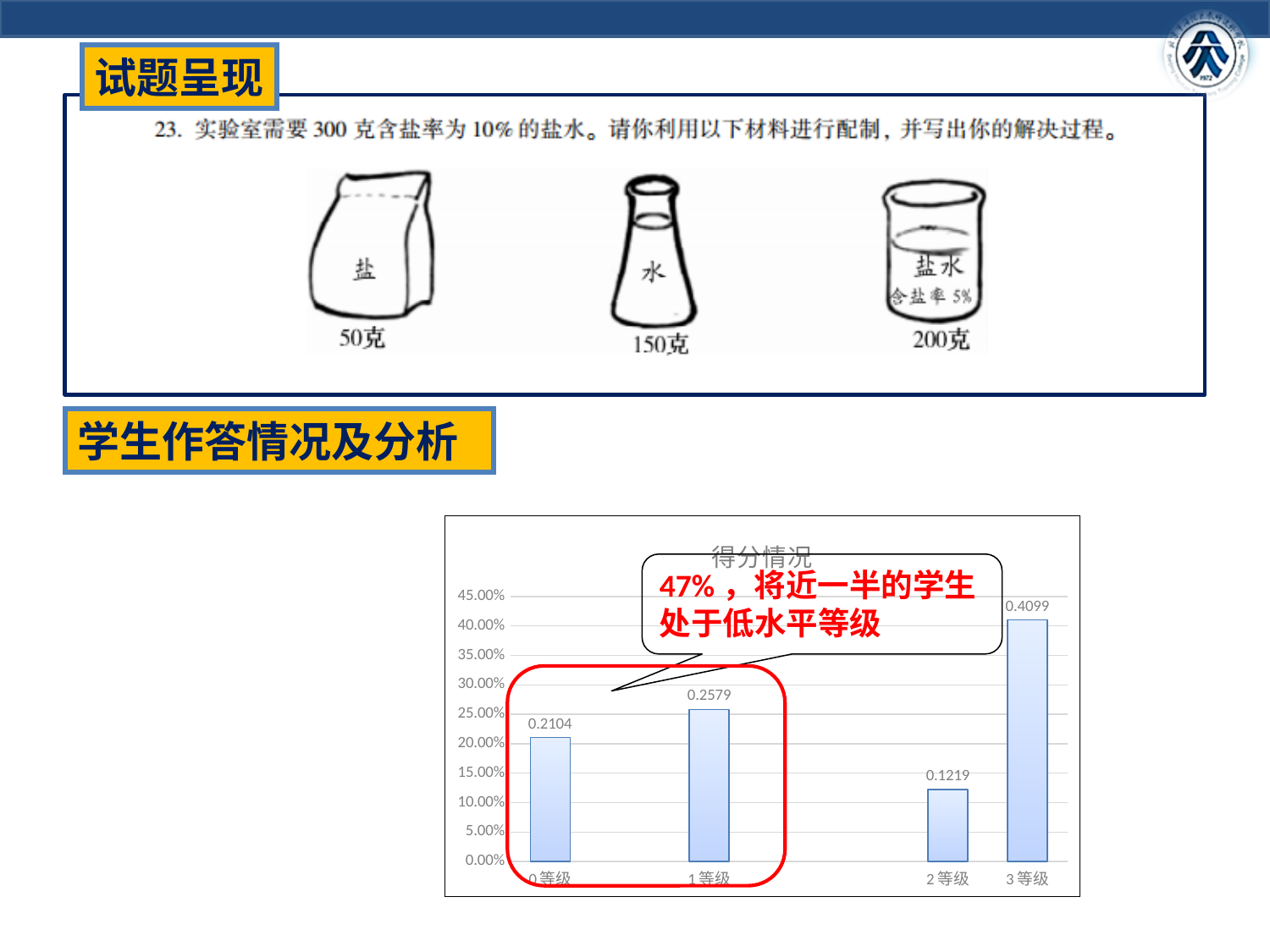
What is the difference between the values for 3等级 and 2等级? 0.2880 What is the title of the chart? 得分情况 Is the value for 3等级 greater or less than 40.00%? greater What type of chart is shown under 学生作答情况及分析? bar chart Which category has the highest value? 3等级 What is the value for 2等级? 0.1219 What is the value for 0等级? 0.2104 How many categories are shown on the x axis? 4 Which category has the lowest value? 2等级 What is the value for 1等级? 0.2579 What is the value for 3等级? 0.4099 Which is larger, the value for 0等级 or the value for 1等级? 1等级